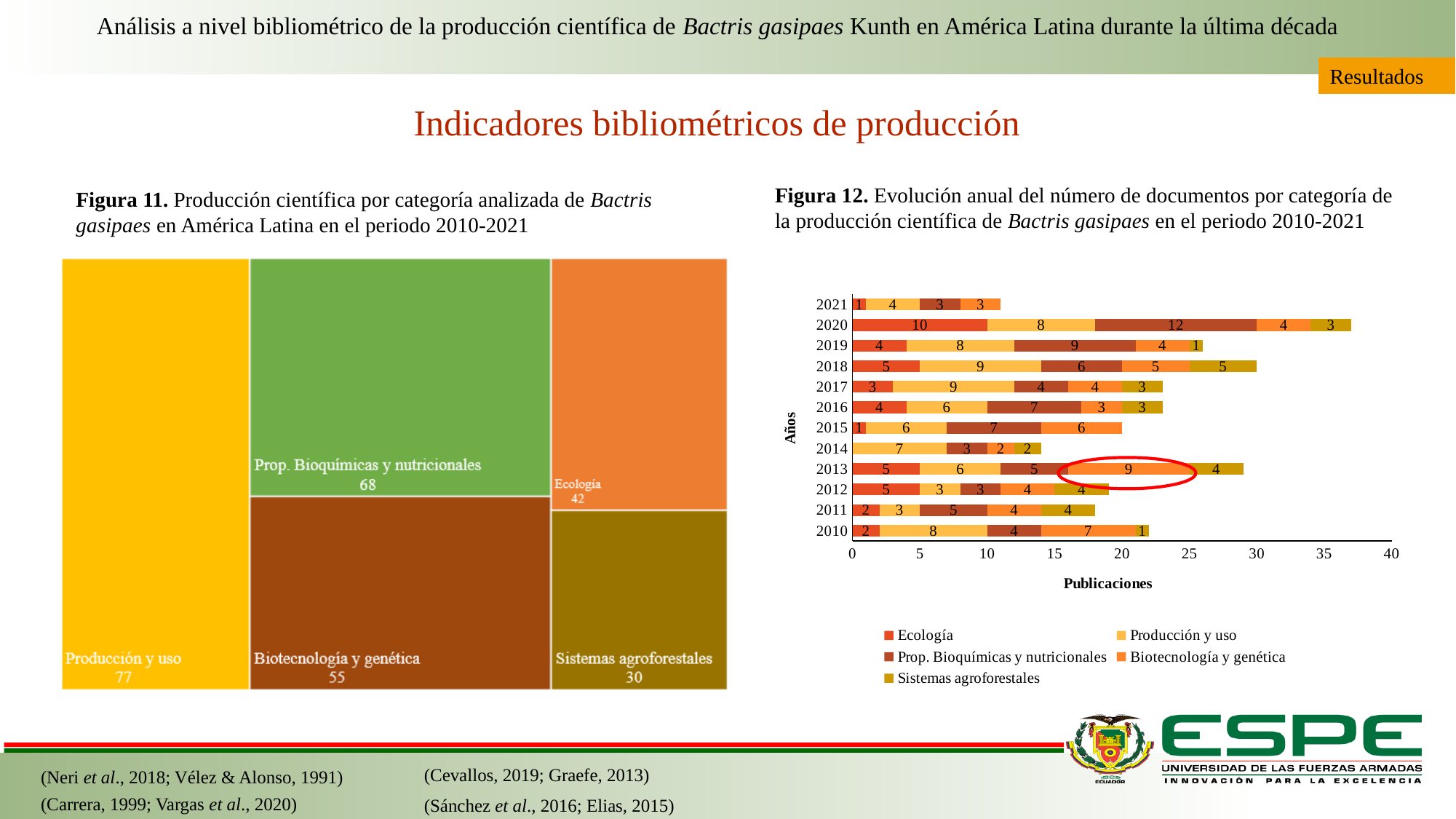
In Figura 11, what is the difference between Prop. Bioquímicas y nutricionales and Biotecnología y genética? 13 In Figura 12, how many series does the legend list? 5 In Figura 12, what is the total number of publications for 2020? 37 In Figura 11, what is the value for Sistemas agroforestales? 30 In Figura 11, what is the value for Producción y uso? 77 What kind of chart is Figura 12? Stacked bar chart In Figura 12, what is the value for Prop. Bioquímicas y nutricionales in 2020? 12 In Figura 12, how many years are shown on the y axis? 12 In Figura 11, which category has the highest value? Producción y uso In Figura 11, how many categories are shown? 5 In Figura 11, which category has the lowest value? Sistemas agroforestales In Figura 12, which year has the highest total number of publications? 2020